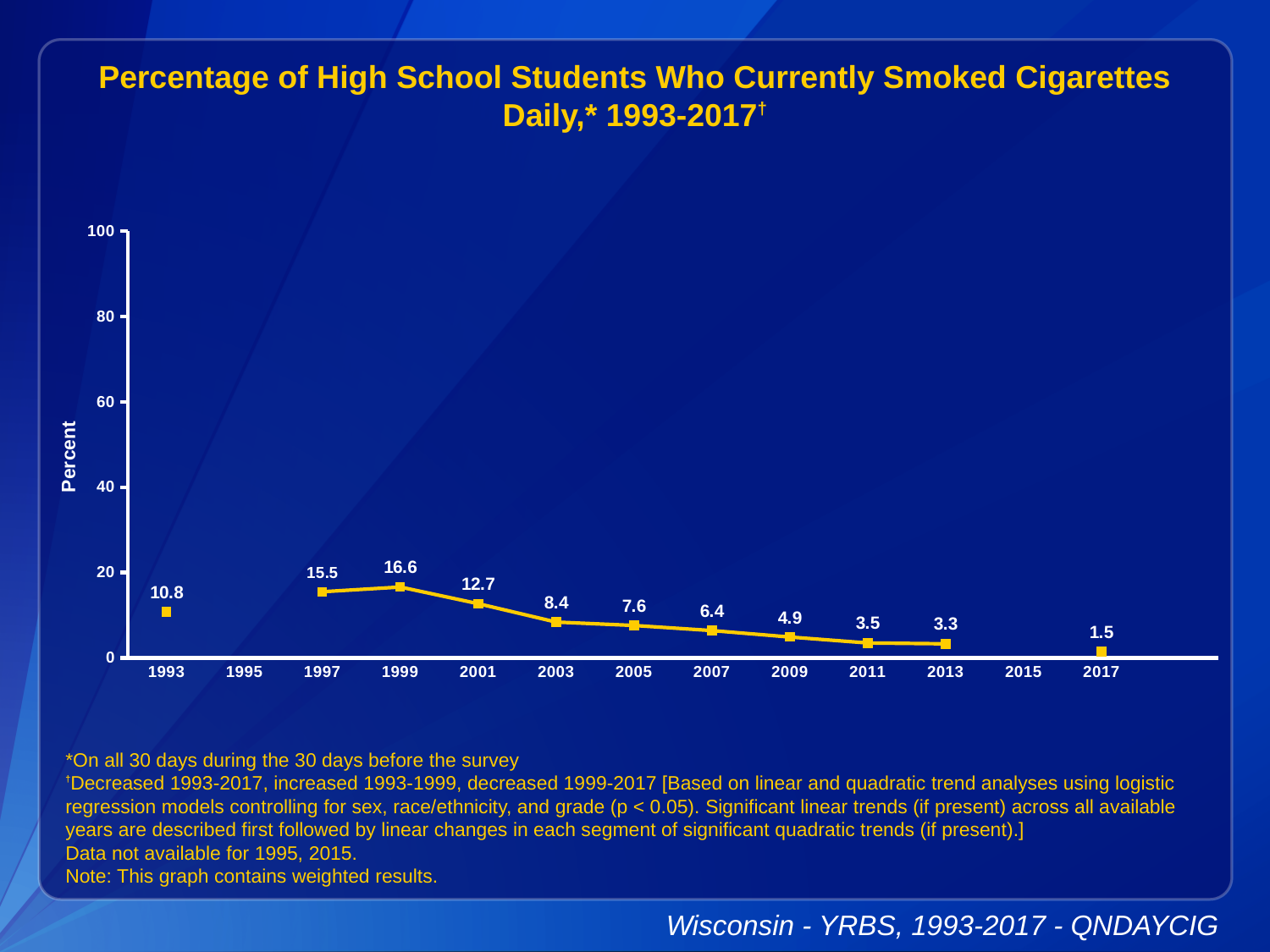
What is the difference between the values for 1997 and 2001? 2.8 What was the percentage of high school students who currently smoked cigarettes daily in 1999? 16.6 Is the value for 1999 greater or less than 20? less How many years have a plotted data point? 11 What value is shown for 1993? 10.8 Which is larger, the value for 1993 or the value for 2001? 2001 Do the values rise or fall from 1999 to 2017? fall What is the difference between the values for 1999 and 2017? 15.1 What value is shown for 2017? 1.5 Which year has the lowest percentage? 2017 Which year has the highest percentage? 1999 What kind of chart is this? line chart